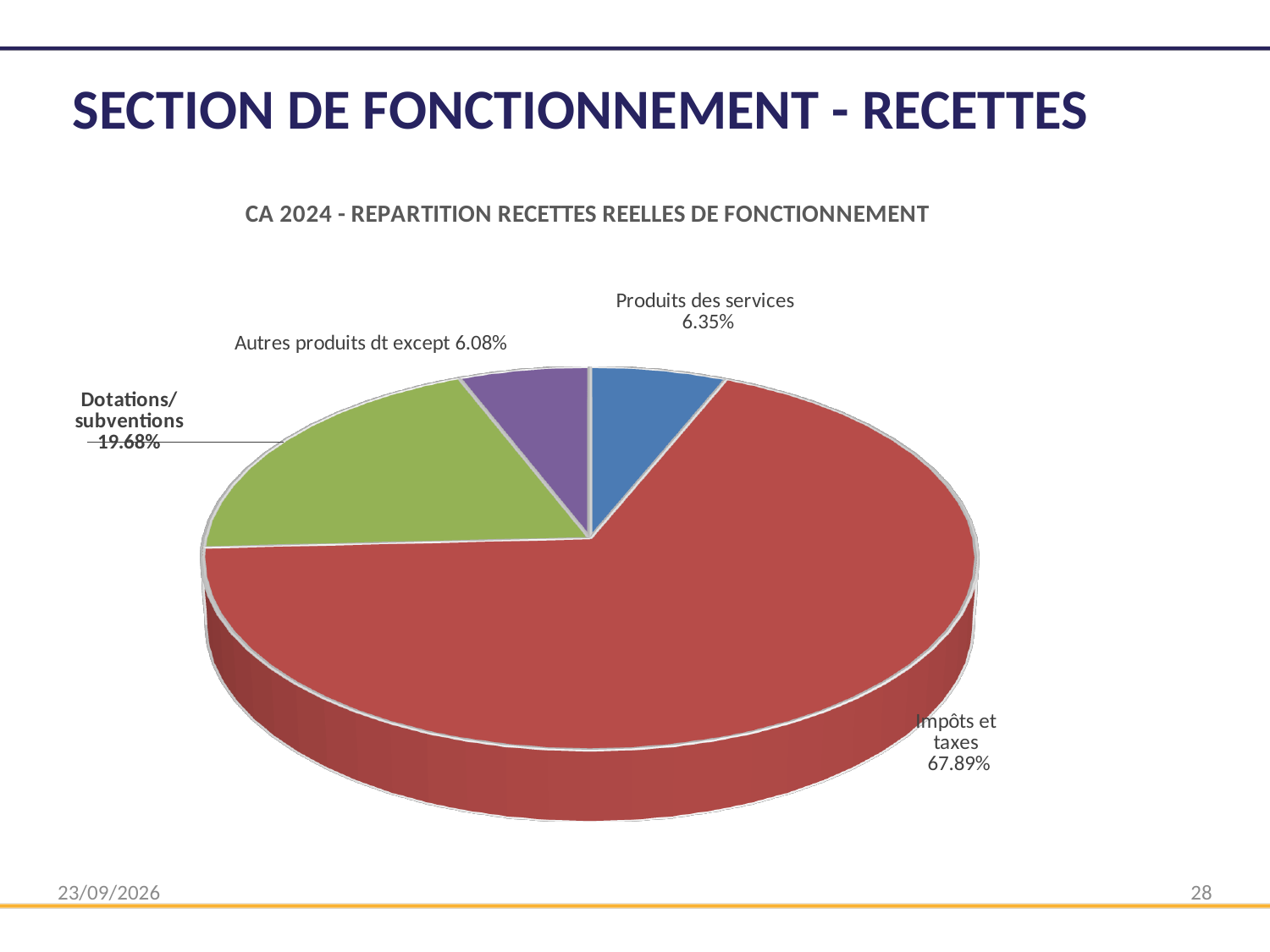
Which category has the largest share of the pie? Impôts et taxes What share of the pie does Autres produits dt except represent? 6.08% What is the title of the chart? CA 2024 - REPARTITION RECETTES REELLES DE FONCTIONNEMENT What share of the pie does Produits des services represent? 6.35% What colour is the slice for Dotations/subventions? Green What is the difference in percentage points between Impôts et taxes and Dotations/subventions? 48.21 How many slices does the pie chart have? 4 Which category has the smallest share of the pie? Autres produits dt except What share of the pie does Impôts et taxes represent? 67.89% What share of the pie does Dotations/subventions represent? 19.68% Which is larger, the share for Produits des services or the share for Autres produits dt except? Produits des services What kind of chart is shown on the slide? Pie chart